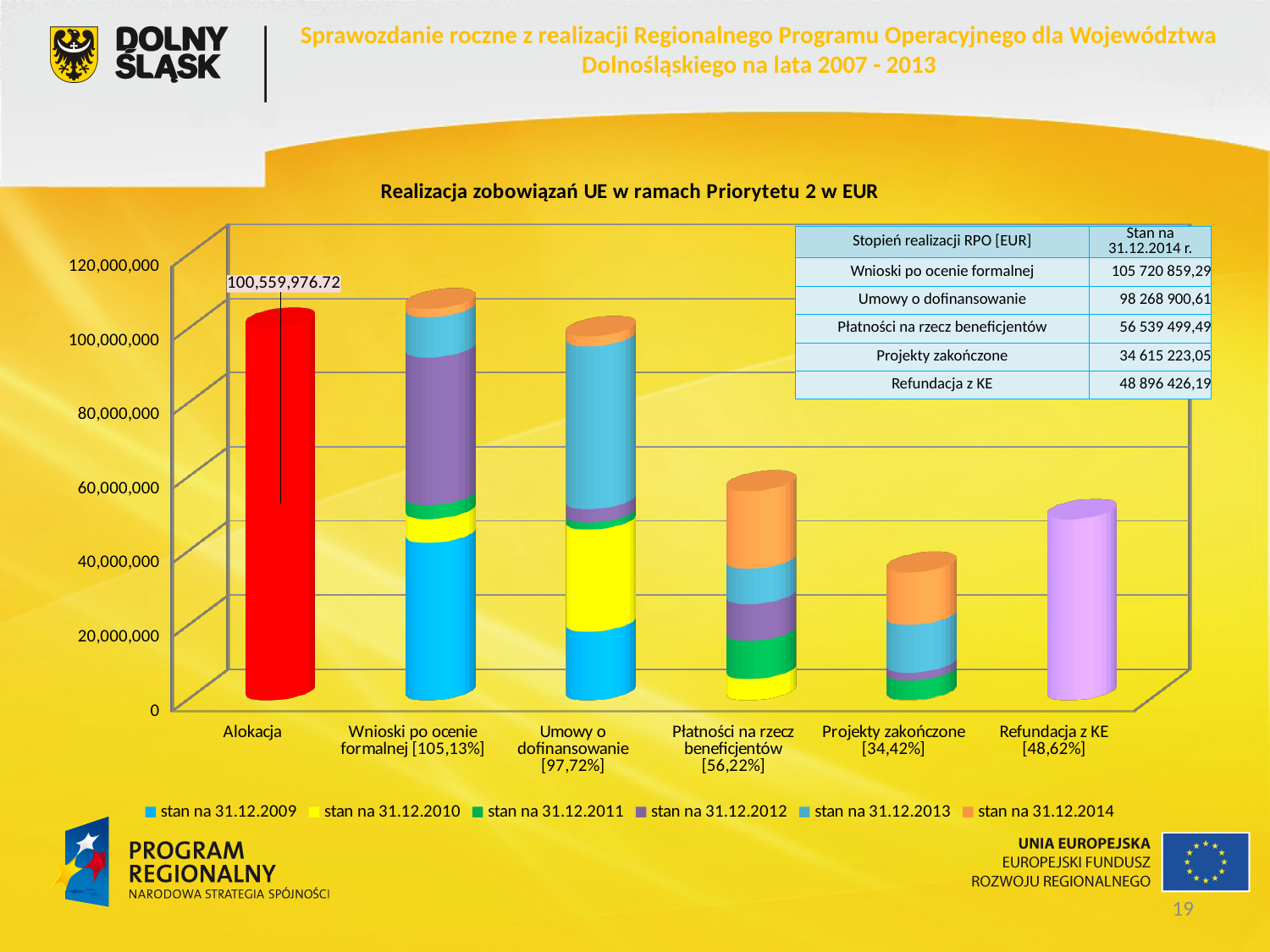
What kind of chart is shown on the slide? Stacked bar chart According to the table on the slide, what is the value for Płatności na rzecz beneficjentów as of 31.12.2014? 56 539 499,49 Using the table values as of 31.12.2014, what is the difference between Wnioski po ocenie formalnej and Umowy o dofinansowanie? 7 451 958,68 Which category has the tallest bar in the chart? Wnioski po ocenie formalnej [105,13%] How many categories are shown on the x axis of the chart? 6 How many series does the chart legend list? 6 What value is labelled on the Alokacja bar? 100,559,976.72 Is the total value for Projekty zakończone greater or less than 40,000,000? less What is the title of the chart? Realizacja zobowiązań UE w ramach Priorytetu 2 w EUR Which category has the shortest bar in the chart? Projekty zakończone [34,42%] According to the table on the slide, what is the value for Wnioski po ocenie formalnej as of 31.12.2014? 105 720 859,29 Is the total value for Refundacja z KE greater or less than 40,000,000? greater